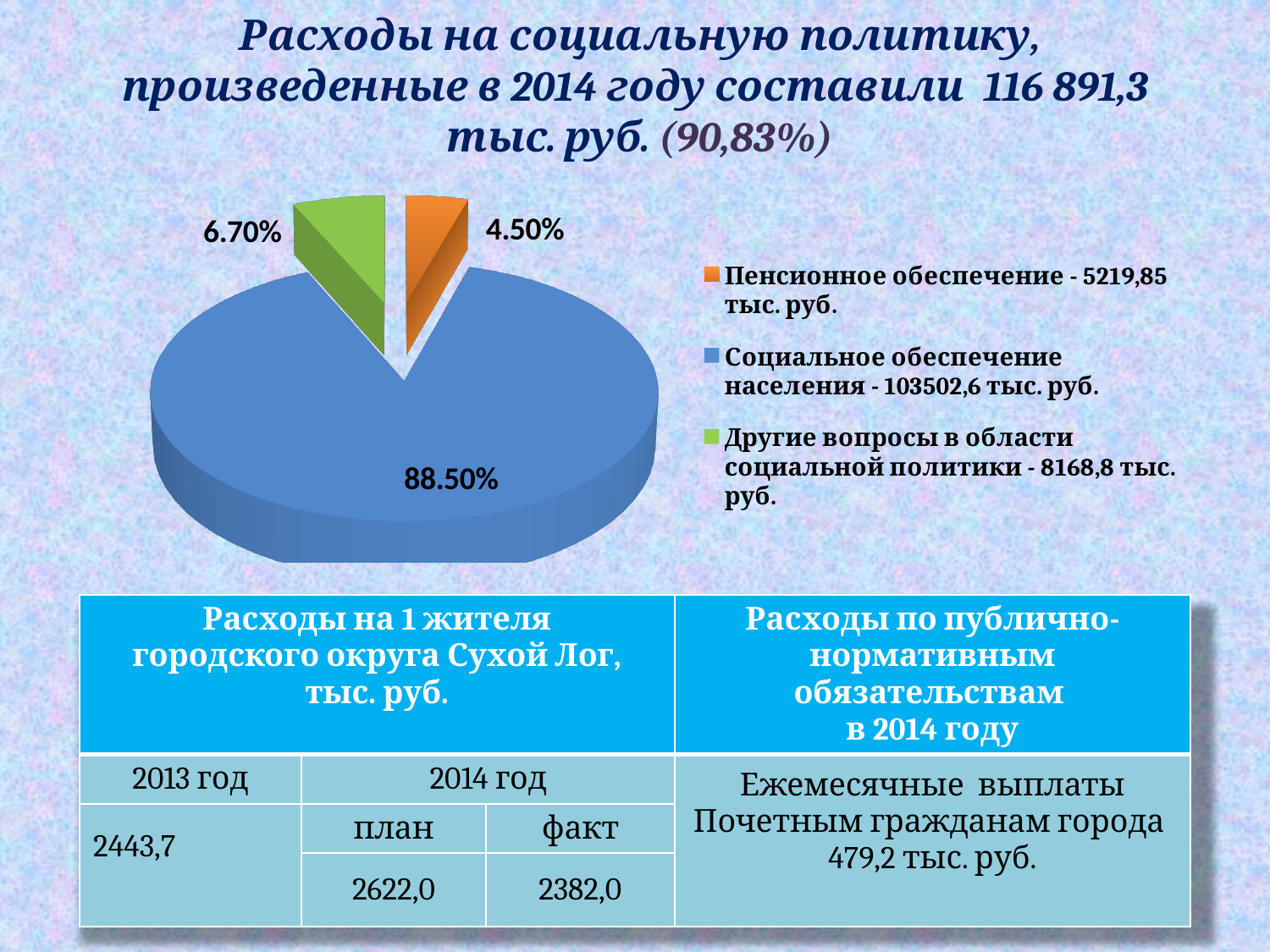
How many slices does the pie chart have? 3 What colour is the slice for Пенсионное обеспечение? Orange What share of the pie does the slice for Социальное обеспечение населения represent? 88.50% Which category has the smallest slice of the pie? Пенсионное обеспечение What kind of chart is shown on the slide? Pie chart What is the difference in percentage points between the Социальное обеспечение населения slice and the Другие вопросы в области социальной политики slice? 81.80% How many entries does the legend list? 3 Which category has the largest slice of the pie? Социальное обеспечение населения What percentage is shown for the Пенсионное обеспечение slice? 4.50% Which slice is larger: Другие вопросы в области социальной политики or Пенсионное обеспечение? Другие вопросы в области социальной политики What percentage is shown for the slice Другие вопросы в области социальной политики? 6.70% What amount in тыс. руб. does the legend give for Социальное обеспечение населения? 103502,6 тыс. руб.